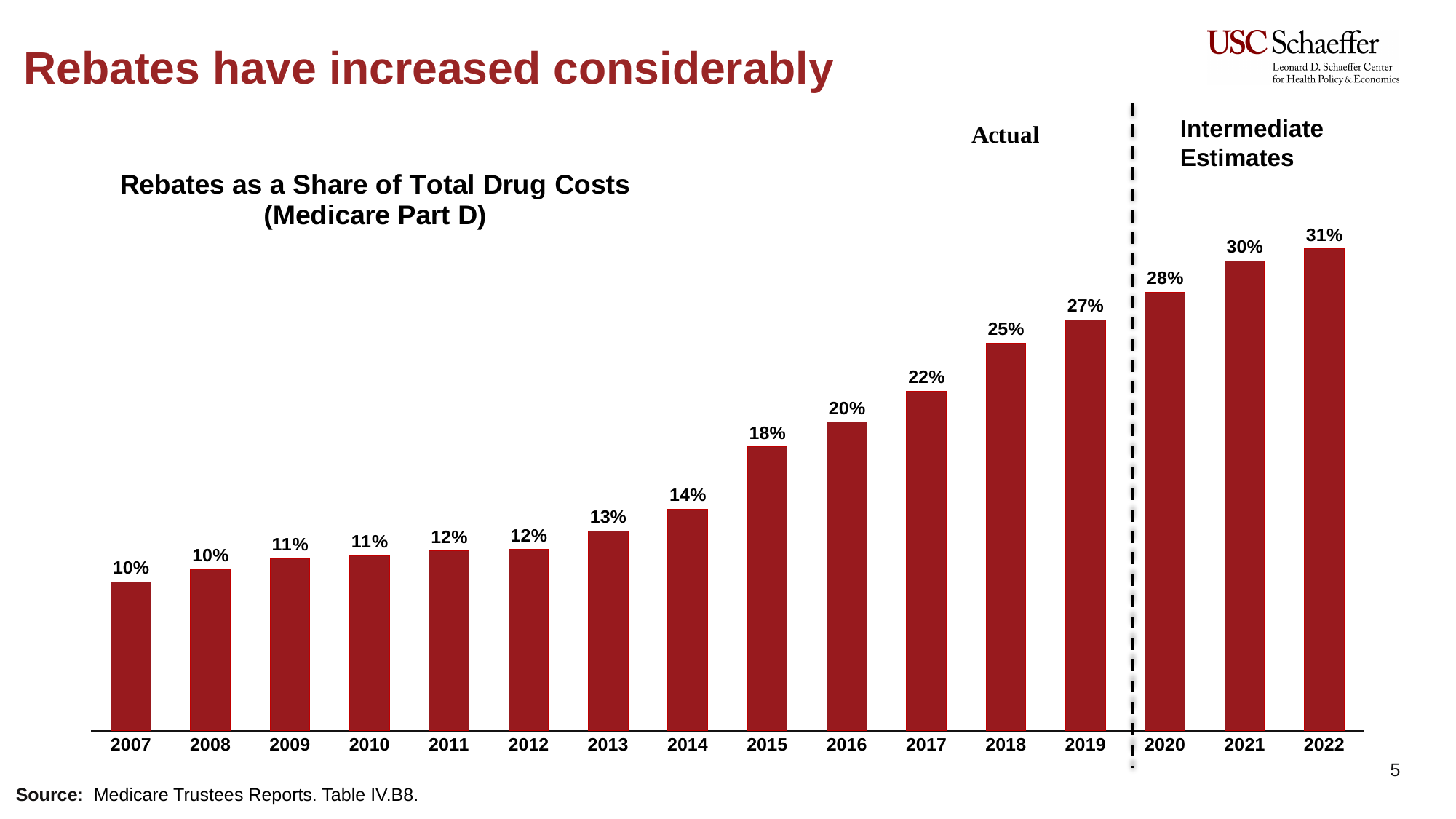
What is the rebate share of total drug costs in 2019? 27% What is the intermediate estimate for rebates as a share of total drug costs in 2022? 31% Which year has a larger rebate share, 2014 or 2017? 2017 What is the difference in rebate share between 2018 and 2016? 5 percentage points What kind of chart is shown on the slide? Bar chart Which year has the highest rebate share of total drug costs? 2022 Do rebates as a share of total drug costs rise or fall from 2007 to 2022? Rise How many years are shown on the x axis of the chart? 16 What is the difference in rebate share between 2019 and 2007? 17 percentage points What is the title of the chart? Rebates as a Share of Total Drug Costs (Medicare Part D) Which year has the lowest rebate share of total drug costs? 2007 and 2008 (tied at 10%) What is the rebate share of total drug costs in 2015? 18%